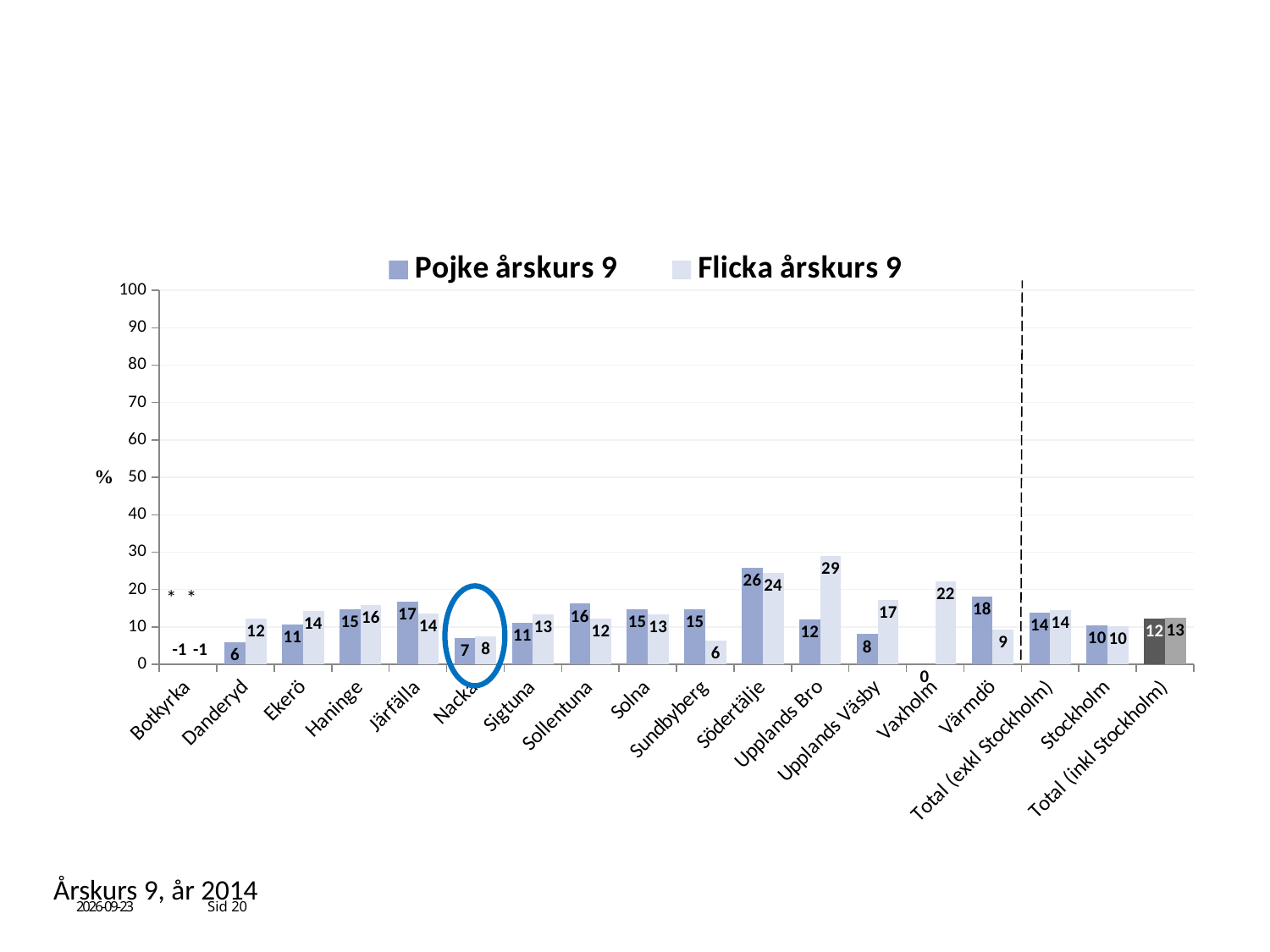
What is the value for Flicka årskurs 9 in Upplands Bro? 29 What is the difference between the Pojke årskurs 9 and Flicka årskurs 9 values in Upplands Bro? 17 What are the values for Pojke årskurs 9 and Flicka årskurs 9 for Total (inkl Stockholm)? 12 and 13 Is the value for Flicka årskurs 9 in Upplands Bro greater or less than 20? greater How many series does the legend list? 2 Which is larger in Sundbyberg, the Pojke årskurs 9 value or the Flicka årskurs 9 value? Pojke årskurs 9 What is the value for Pojke årskurs 9 in Södertälje? 26 Which municipality has the highest value for Flicka årskurs 9? Upplands Bro What kind of chart is shown on the slide? Bar chart Which municipality has the highest value for Pojke årskurs 9? Södertälje Which municipality is circled on the chart? Nacka What is the value for Flicka årskurs 9 in Vaxholm? 22